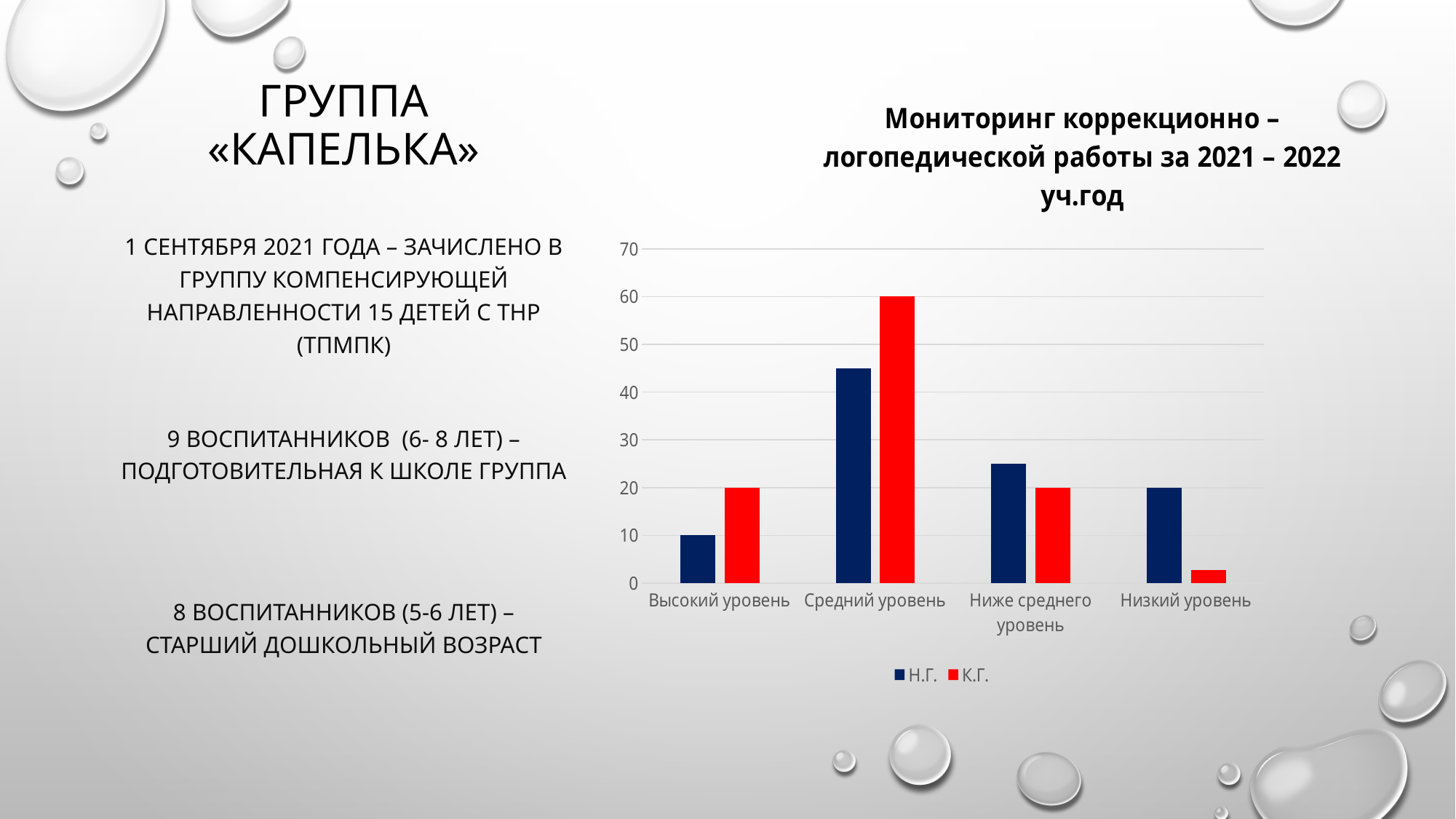
Is the К.Г. value for Низкий уровень greater or less than 10? less What is the value of Н.Г. for Высокий уровень? 10 Which category has the highest К.Г. value? Средний уровень What is the value of Н.Г. for Низкий уровень? 20 How many categories are shown on the x axis of the chart? 4 Which category has the lowest К.Г. value? Низкий уровень What is the difference between the К.Г. and Н.Г. values for Высокий уровень? 10 What kind of chart is shown on the slide? bar chart What is the value of К.Г. for Средний уровень? 60 Is the Н.Г. value for Средний уровень greater or less than 40? greater For Высокий уровень, which series is larger, Н.Г. or К.Г.? К.Г. How many series does the legend of the chart list? 2